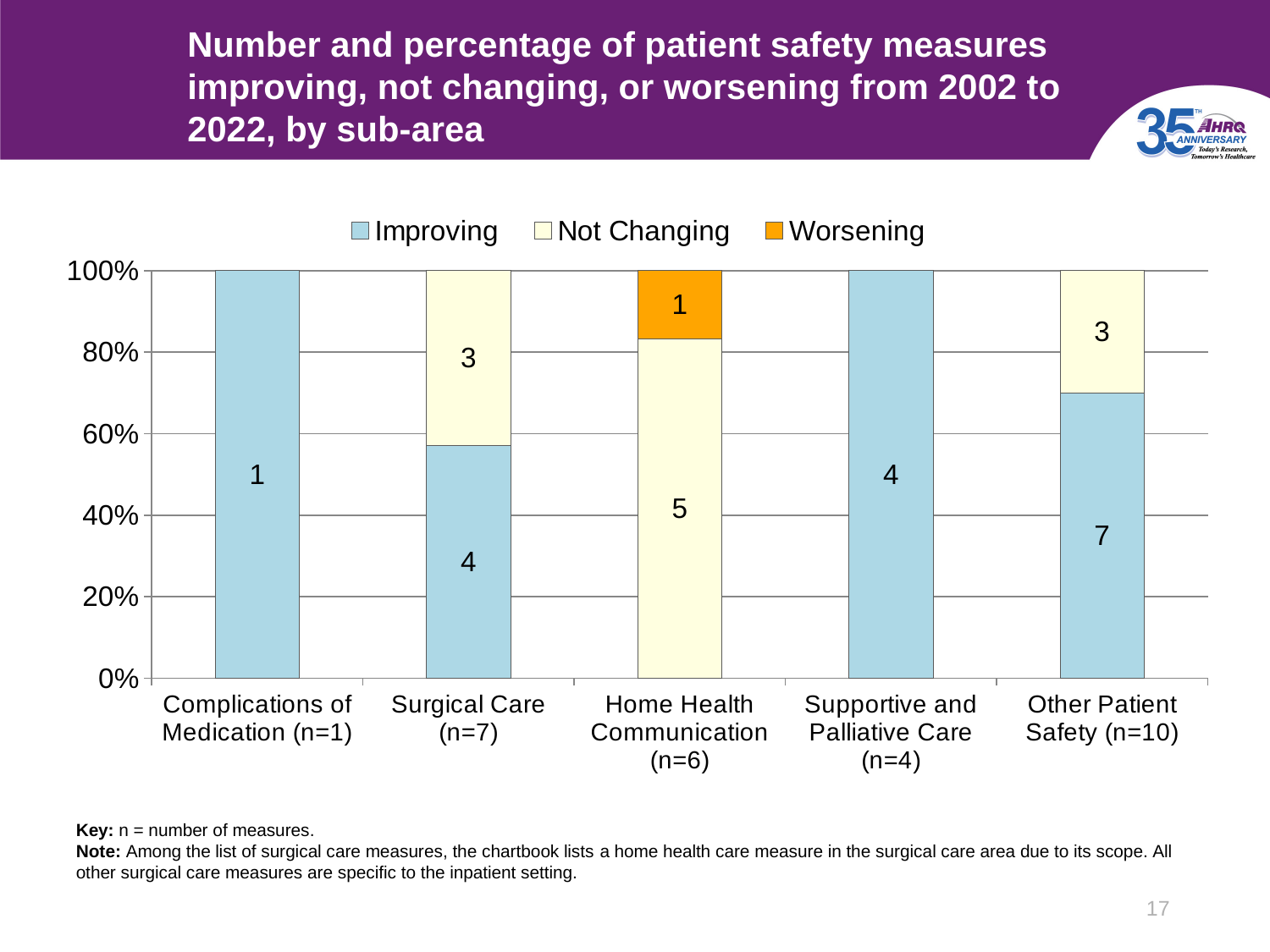
Is the Improving share for Other Patient Safety greater or less than 60%? greater Which sub-area is the only one with a Worsening measure? Home Health Communication How many Surgical Care measures are in the Improving category? 4 Which is larger for Surgical Care: the number of Improving measures or the number of Not Changing measures? Improving What kind of chart is shown on the slide? Stacked bar chart How many Other Patient Safety measures are Not Changing? 3 How many series does the legend list? 3 How many sub-areas are shown on the x axis? 5 How many Supportive and Palliative Care measures are Improving? 4 How many Home Health Communication measures are Worsening? 1 Which sub-area has the most Improving measures? Other Patient Safety What is the difference between the number of Improving and Not Changing measures for Other Patient Safety? 4